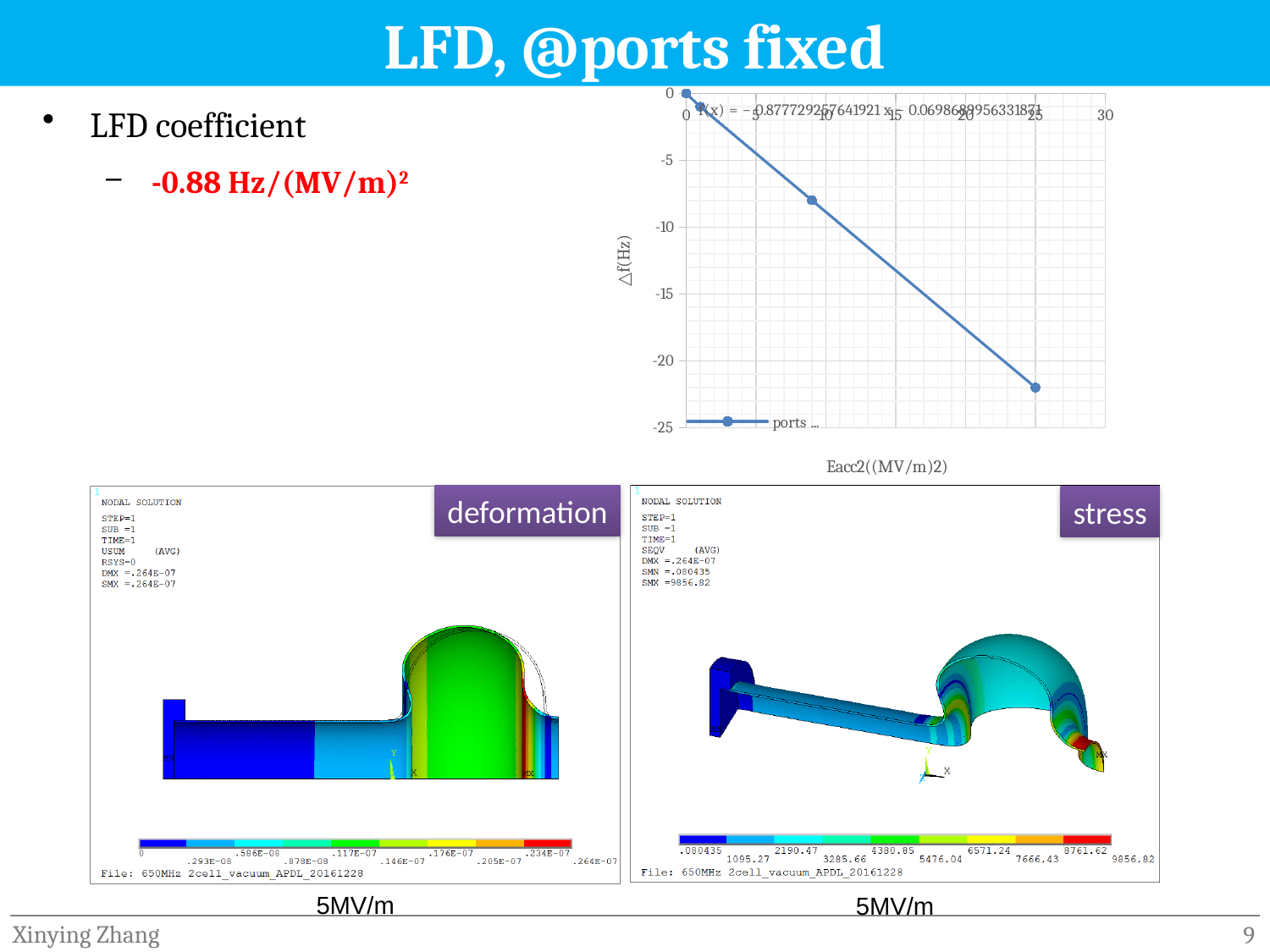
How many series does the chart's legend list? 1 How many data points are plotted on the chart? 4 What is the title of the chart's horizontal axis? Eacc2((MV/m)2) Which data point has the lowest Δf value? the point at Eacc² = 25 What is the title of the chart's vertical axis? △f(Hz) Do the Δf values rise or fall as Eacc² increases along the x axis? fall What kind of chart is shown on the slide? line chart What is the Δf value of the data point at Eacc² = 0? 0 Which data point has the highest Δf value? the point at Eacc² = 0 Is the Δf value of the data point at Eacc² = 25 greater or less than -20? less